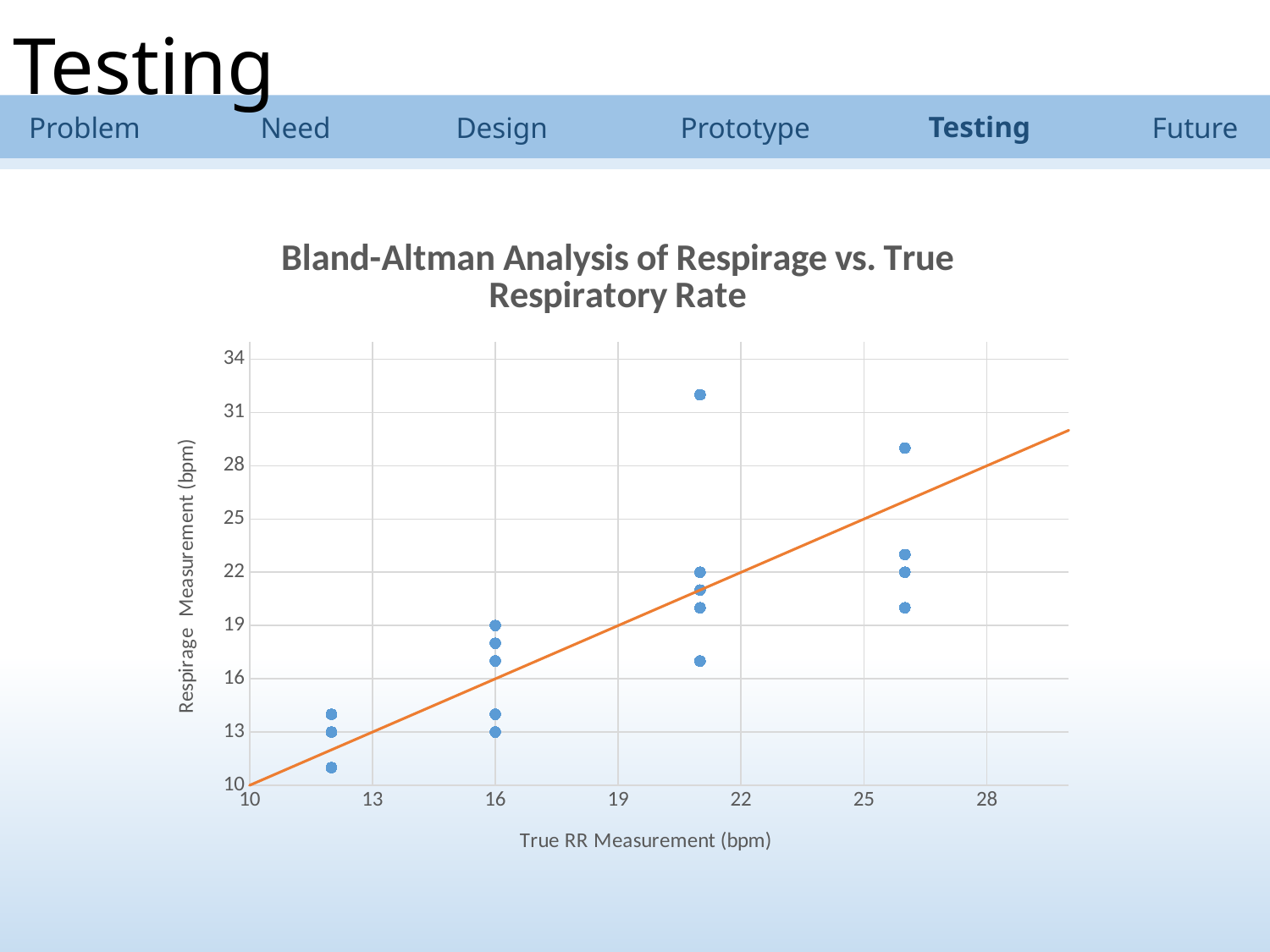
Is the highest point in the cluster near a true RR of 26 greater or less than 28 on the vertical axis? greater How many distinct true RR measurement values have plotted points in the chart? 4 What is the title of the chart? Bland-Altman Analysis of Respirage vs. True Respiratory Rate Do the plotted Respirage measurements generally rise or fall as the true RR measurement increases along the x axis? rise Is the lowest point in the cluster near a true RR of 21 greater or less than 16 on the vertical axis? greater Is the highest plotted Respirage measurement greater or less than 31? greater What is the label of the vertical axis of the chart? Respirage Measurement (bpm) What kind of chart is shown on the slide? scatter chart